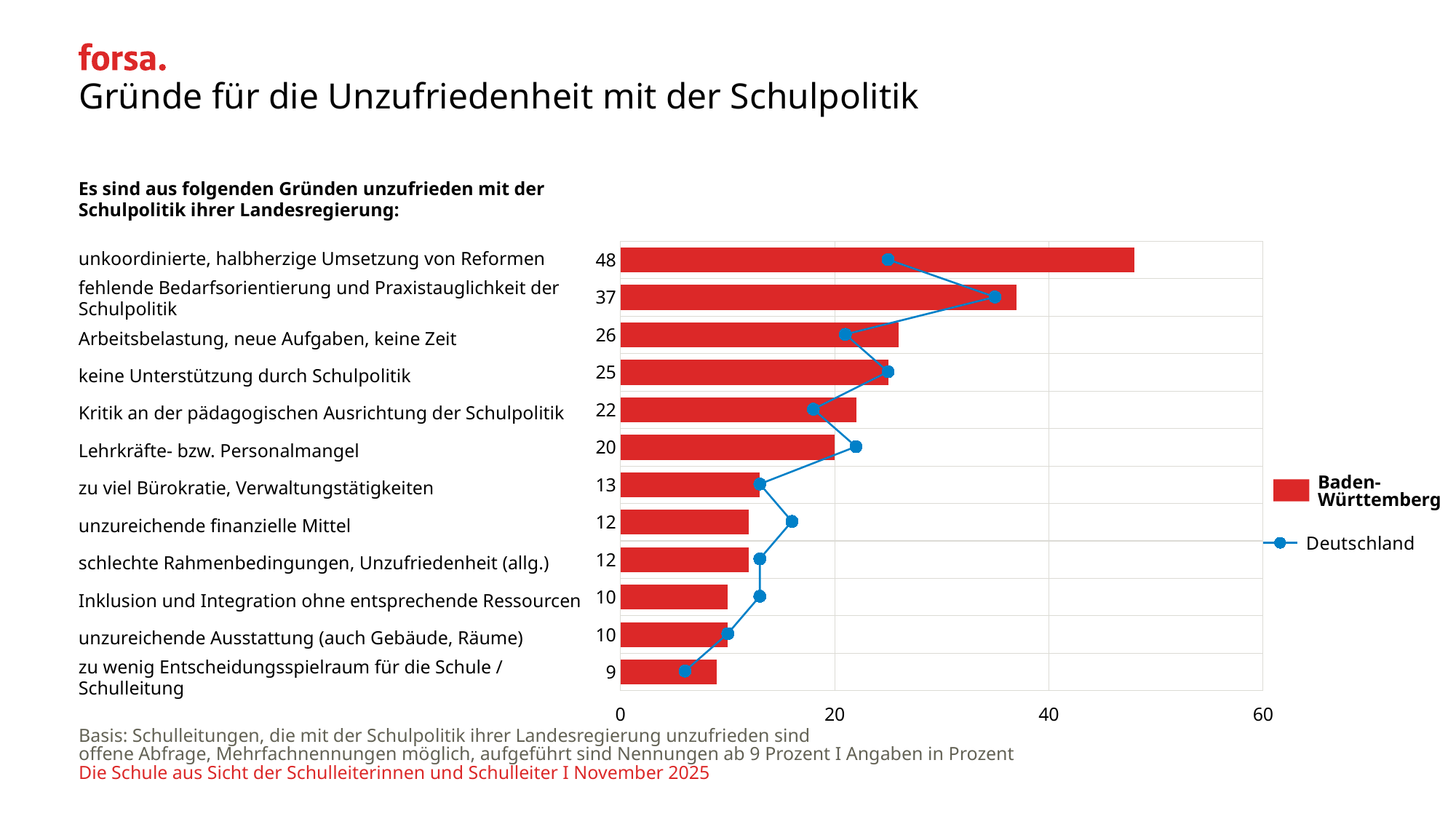
How many reasons are listed in the chart? 12 Is the Deutschland value for "fehlende Bedarfsorientierung und Praxistauglichkeit der Schulpolitik" greater or less than 20? greater What is the Baden-Württemberg value for "Lehrkräfte- bzw. Personalmangel"? 20 What is the difference between the Baden-Württemberg values for "unkoordinierte, halbherzige Umsetzung von Reformen" and "fehlende Bedarfsorientierung und Praxistauglichkeit der Schulpolitik"? 11 Which reason has the highest Baden-Württemberg value? unkoordinierte, halbherzige Umsetzung von Reformen What colour are the Baden-Württemberg bars? red Which has the larger Baden-Württemberg value: "Kritik an der pädagogischen Ausrichtung der Schulpolitik" or "zu viel Bürokratie, Verwaltungstätigkeiten"? Kritik an der pädagogischen Ausrichtung der Schulpolitik Which reason has the lowest Baden-Württemberg value? zu wenig Entscheidungsspielraum für die Schule / Schulleitung Is the Deutschland value for "unkoordinierte, halbherzige Umsetzung von Reformen" greater or less than 40? less What is the Baden-Württemberg value for "zu viel Bürokratie, Verwaltungstätigkeiten"? 13 How many series does the legend list? 2 What is the Baden-Württemberg value for "unkoordinierte, halbherzige Umsetzung von Reformen"? 48